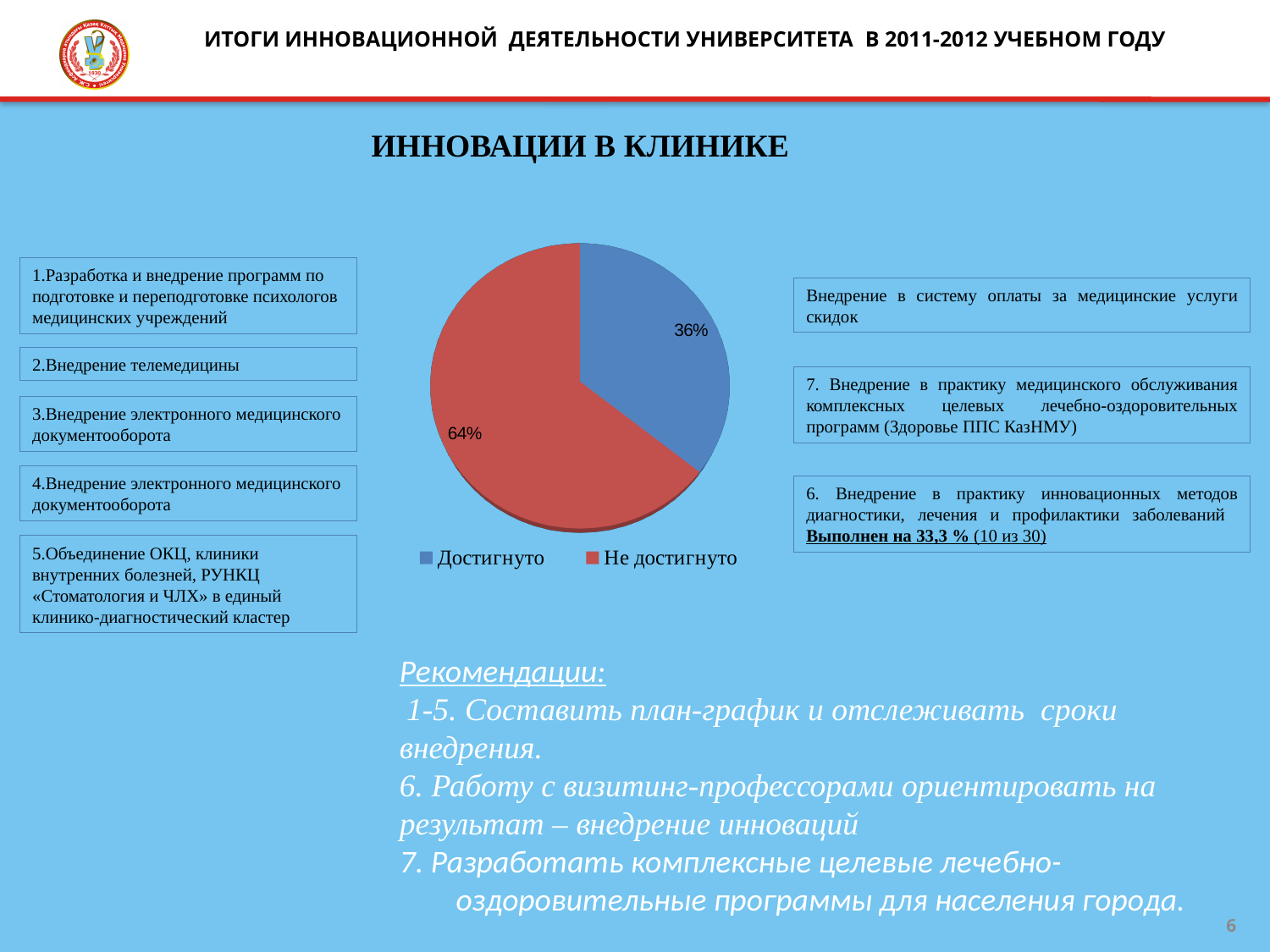
What share of the pie chart is labelled "Не достигнуто"? 64% What share of the pie chart is labelled "Достигнуто"? 36% Which slice of the pie chart is the largest? Не достигнуто What colour is the "Достигнуто" slice in the pie chart? blue What kind of chart is shown on the slide? pie chart How many entries does the legend of the pie chart list? 2 Which is larger in the pie chart: "Достигнуто" or "Не достигнуто"? Не достигнуто Which slice of the pie chart is the smallest? Достигнуто What colour is the "Не достигнуто" slice in the pie chart? red How many slices does the pie chart have? 2 What is the difference in percentage points between the "Не достигнуто" and "Достигнуто" slices? 28 What is the total of the two slices shown in the pie chart? 100%